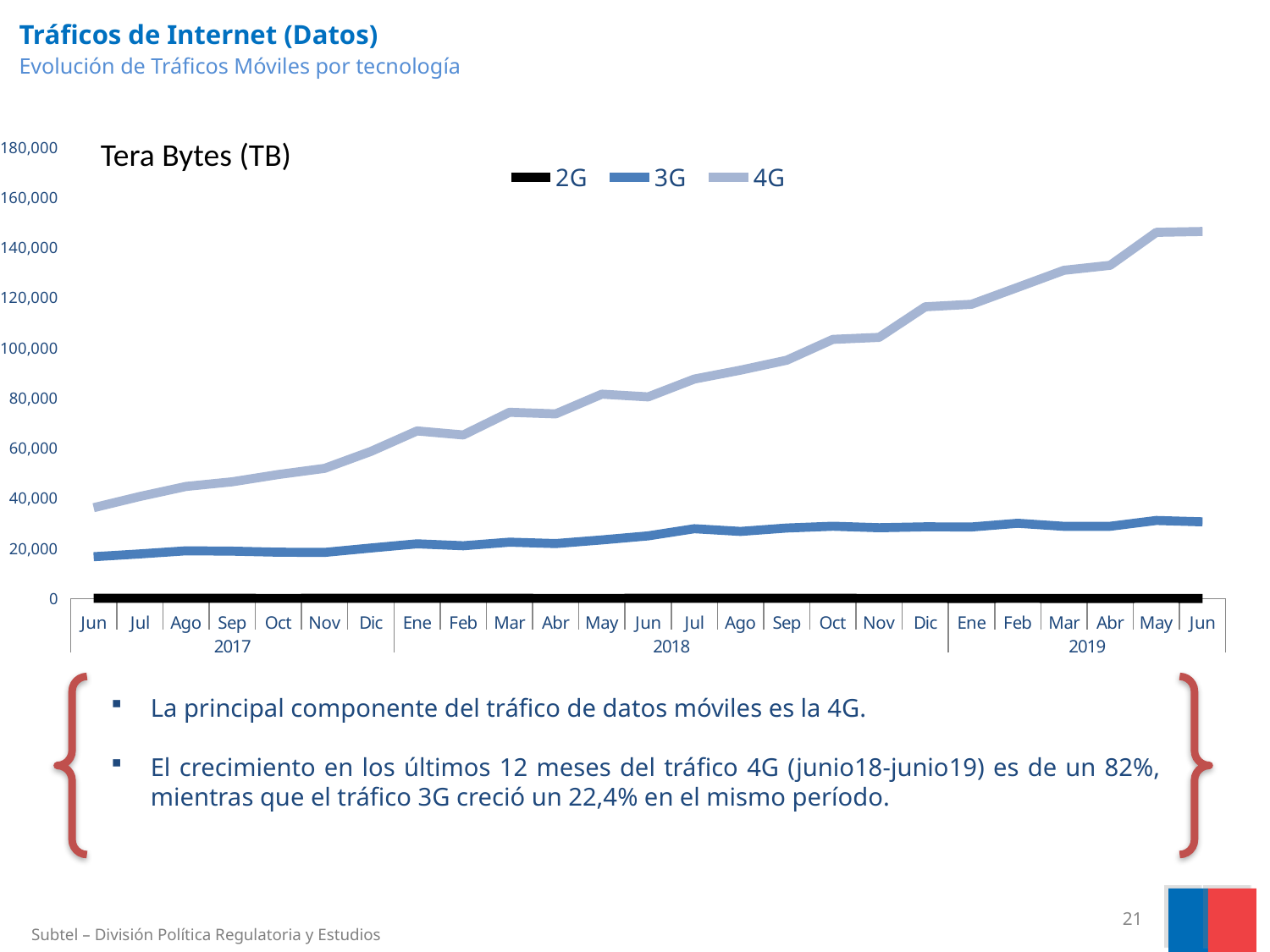
Which technology has the highest traffic in Jun 2019? 4G Is the 4G value for Jun 2019 greater or less than 140,000? greater Is the 3G value for Jun 2019 greater or less than 20,000? greater Which technology has the lowest traffic across the whole period? 2G Does the 4G traffic rise or fall from Jun 2017 to Jun 2019? rise How many series does the legend list? 3 Which series are listed in the legend? 2G, 3G, 4G What kind of chart is shown on the slide? line chart What unit label is shown at the top of the chart's y axis? Tera Bytes (TB) Is the 4G value for Jun 2017 greater or less than 40,000? less Which is larger in Jun 2019, the 4G value or the 3G value? 4G How many monthly points are plotted along the x axis? 25